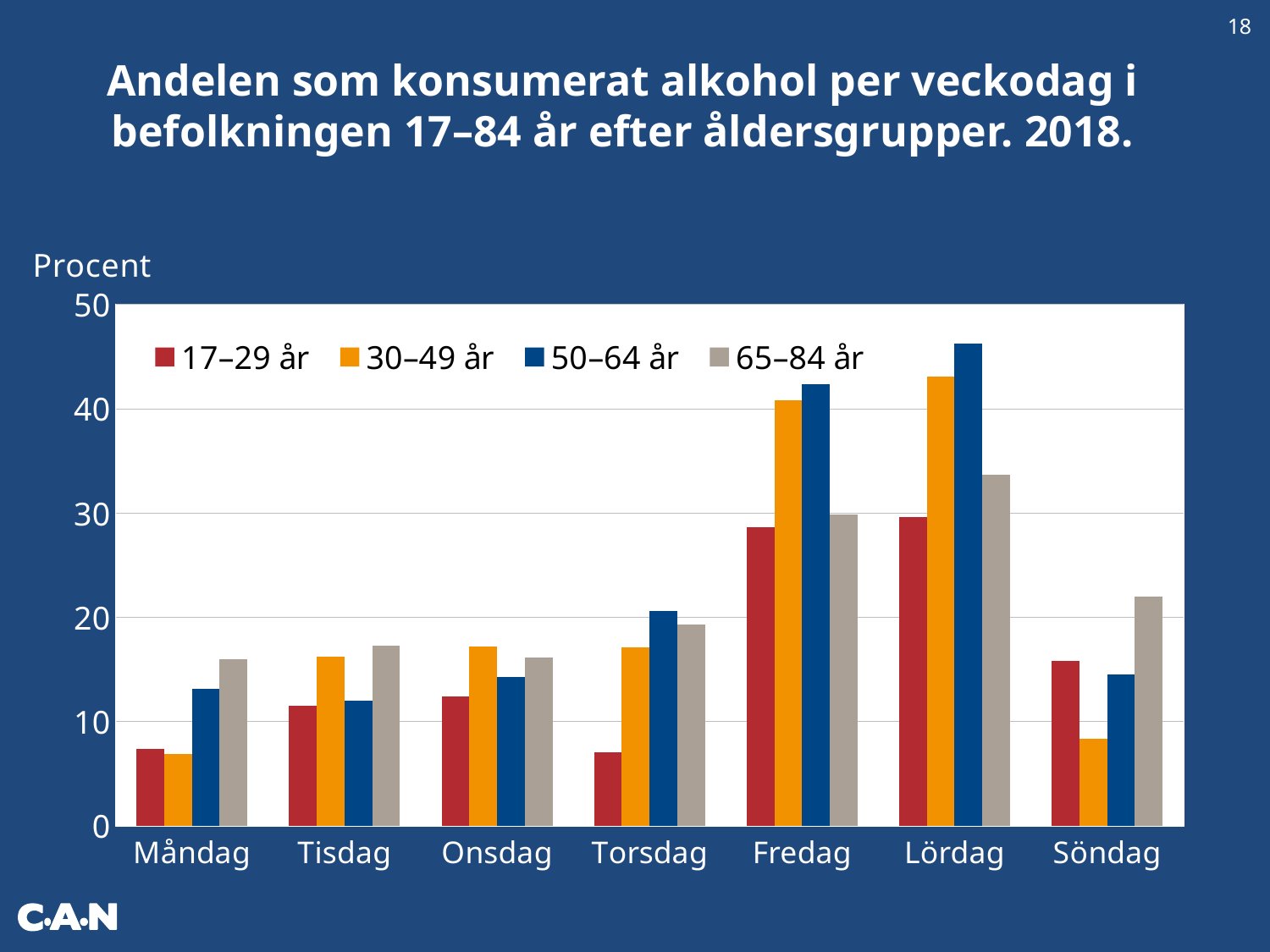
How many weekdays (categories) are shown on the x axis? 7 What label is shown above the y axis? Procent On Måndag, which age group has the highest value? 65–84 år How many series does the legend list? 4 Is the value for 50–64 år on Lördag greater or less than 40? greater For the 65–84 år series, which weekday has the highest value? Lördag What kind of chart is shown on the slide? bar chart On Söndag, which is larger: the value for 65–84 år or for 17–29 år? 65–84 år Is the value for 17–29 år on Torsdag greater or less than 10? less For the 50–64 år series, which weekday has the highest value? Lördag On Fredag, which is larger: the value for 30–49 år or for 17–29 år? 30–49 år Is the value for 65–84 år on Söndag greater or less than 20? greater